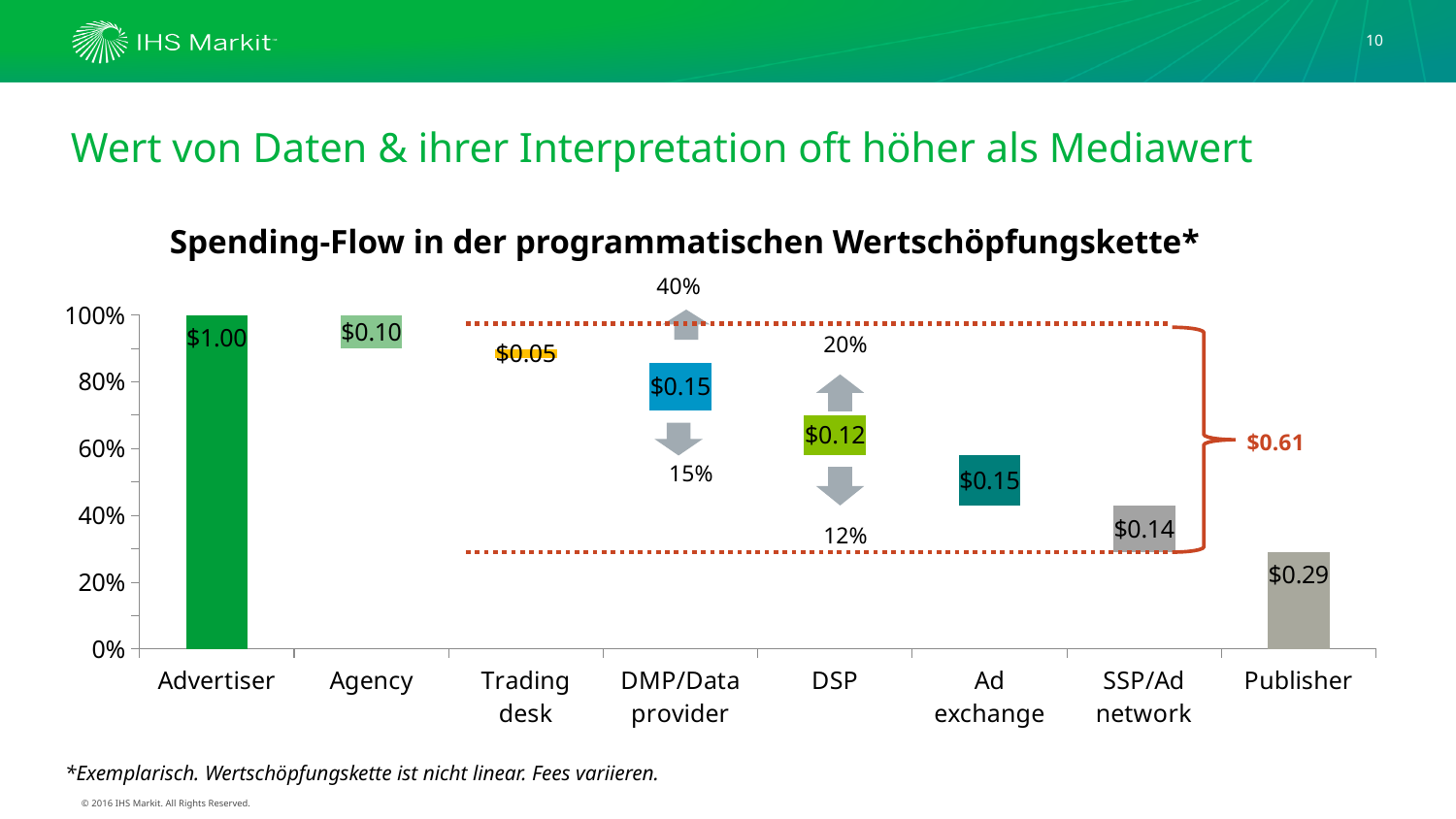
What is the value shown for Agency? $0.10 How many categories are shown on the x axis? 8 Which category has the lowest value? Trading desk What is the value shown for Publisher? $0.29 What is the value shown for SSP/Ad network? $0.14 What amount is labelled next to the red bracket on the right of the chart? $0.61 Which category has the highest value? Advertiser What is the value shown for DSP? $0.12 What is the difference between the values for Advertiser and Publisher? $0.71 What is the value shown for Advertiser? $1.00 What kind of chart is this? Bar chart Which is larger, the value for Agency or the value for DSP? DSP